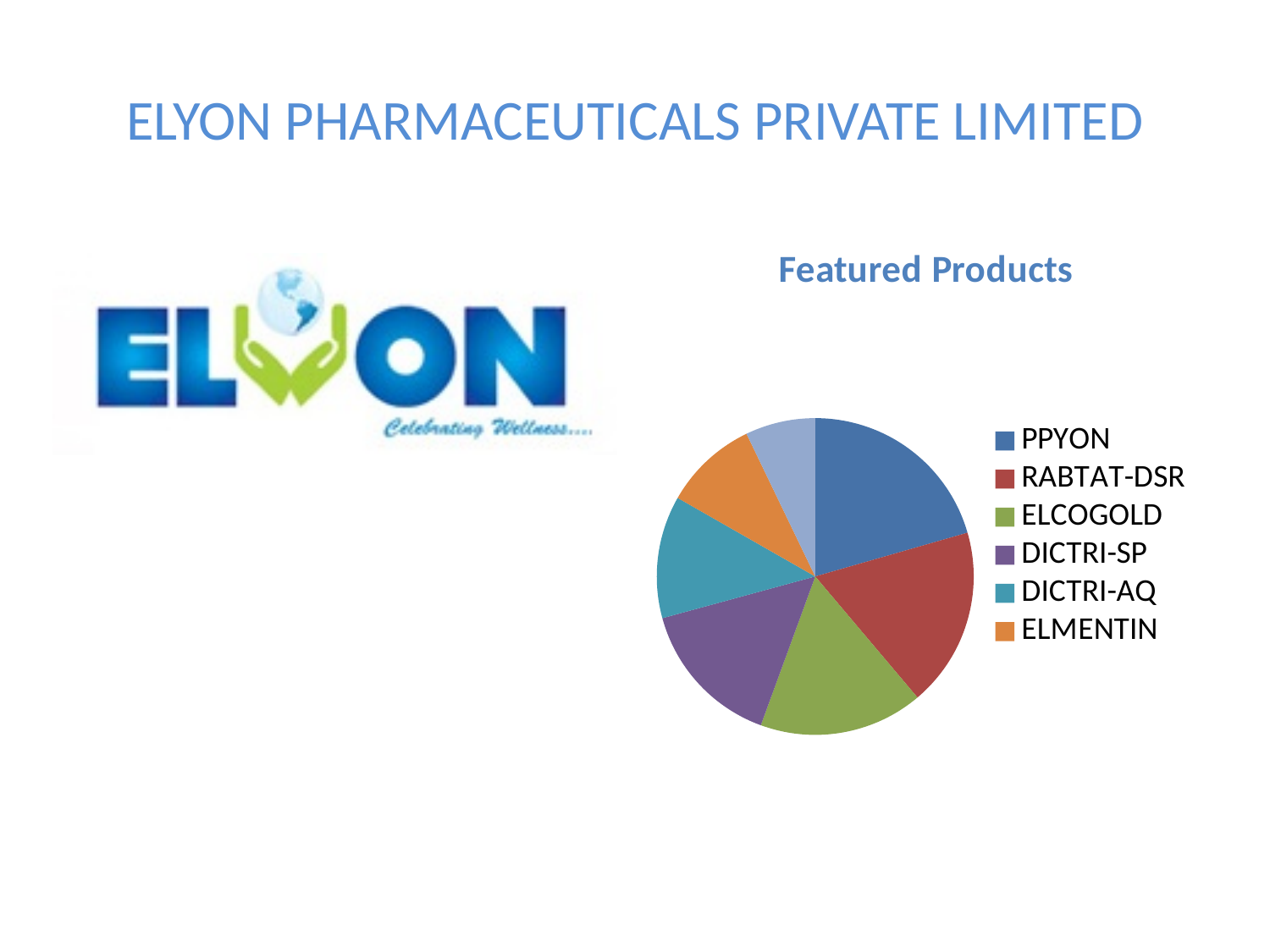
What is the title of the chart on the slide? Featured Products In the Featured Products pie chart, which slice is larger, ELCOGOLD or ELMENTIN? ELCOGOLD How many slices does the Featured Products pie chart have? 7 In the Featured Products pie chart, which slice is larger, RABTAT-DSR or DICTRI-AQ? RABTAT-DSR What kind of chart is shown under the heading "Featured Products"? Pie chart Which legend entry is listed first in the Featured Products pie chart? PPYON In the Featured Products pie chart, which slice is larger, DICTRI-SP or ELMENTIN? DICTRI-SP How many entries does the legend of the Featured Products pie chart list? 6